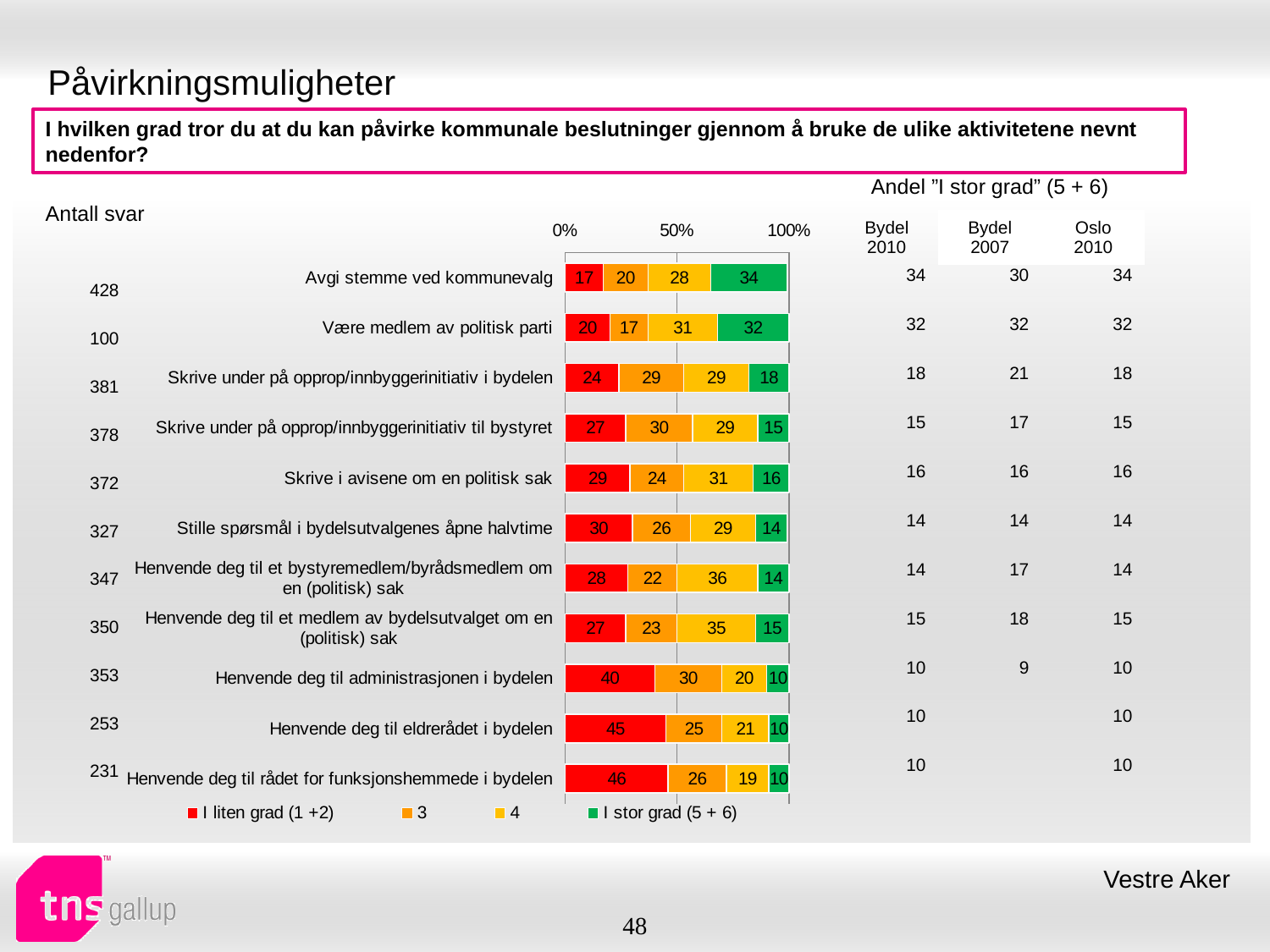
Which colour represents "I stor grad (5 + 6)" in the legend? Green How many categories are shown in the bar chart? 11 Which category has the lowest "I liten grad (1 +2)" value? Avgi stemme ved kommunevalg Which is larger: the "3" segment for "Skrive under på opprop/innbyggerinitiativ til bystyret" or the "3" segment for "Skrive i avisene om en politisk sak"? Skrive under på opprop/innbyggerinitiativ til bystyret Which category has the highest "I stor grad (5 + 6)" value? Avgi stemme ved kommunevalg How many series does the legend list? 4 What is the total of the stacked bar for "Være medlem av politisk parti"? 100 What kind of chart is shown on the slide? Stacked bar chart What is the difference between the "I liten grad (1 +2)" values for "Henvende deg til eldrerådet i bydelen" and "Avgi stemme ved kommunevalg"? 28 What is the value of the "4" segment for "Henvende deg til et bystyremedlem/byrådsmedlem om en (politisk) sak"? 36 What is the value of the "I stor grad (5 + 6)" segment for "Avgi stemme ved kommunevalg"? 34 What is the value of the "I liten grad (1 +2)" segment for "Henvende deg til rådet for funksjonshemmede i bydelen"? 46